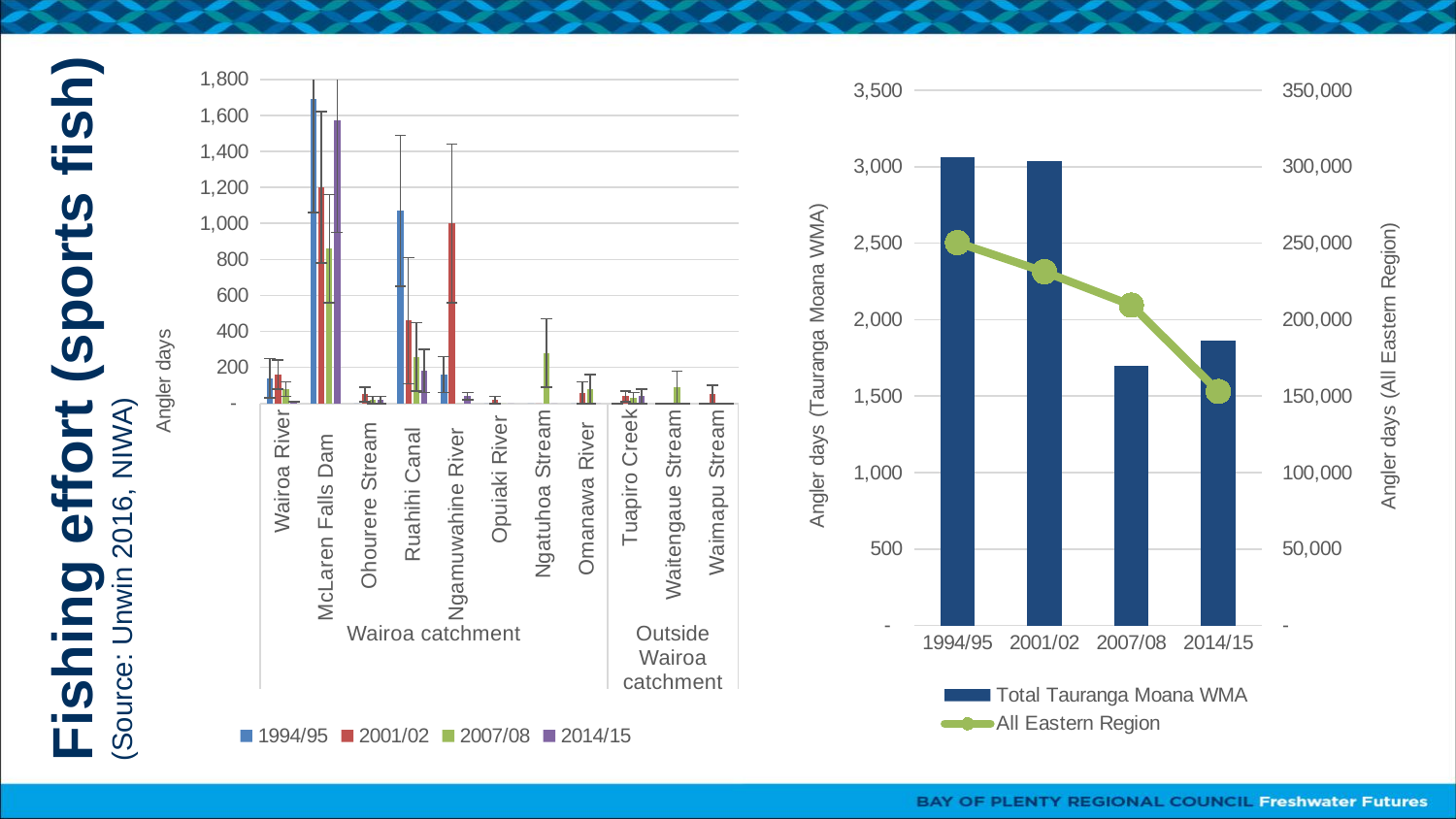
In the right chart, which period has the lowest Total Tauranga Moana WMA angler days? 2007/08 What kind of chart is the chart on the left of the slide? bar chart How many categories (water bodies) are shown on the x axis of the left chart? 11 In the left chart, which water body has the highest angler days? McLaren Falls Dam In the right chart, do the All Eastern Region angler days rise or fall from 1994/95 to 2014/15? fall In the right chart, how many series does the legend list? 2 How many series does the legend of the left chart list? 4 In the right chart, is the Total Tauranga Moana WMA value for 2014/15 greater or less than 2,000? less In the left chart, is the 1994/95 value for McLaren Falls Dam greater or less than 1,600? greater In the right chart, how many periods are shown on the x axis? 4 In the left chart, is the 1994/95 value for Ruahihi Canal greater or less than 1,000? greater In the left chart, which is larger for Ruahihi Canal: the 1994/95 value or the 2001/02 value? 1994/95